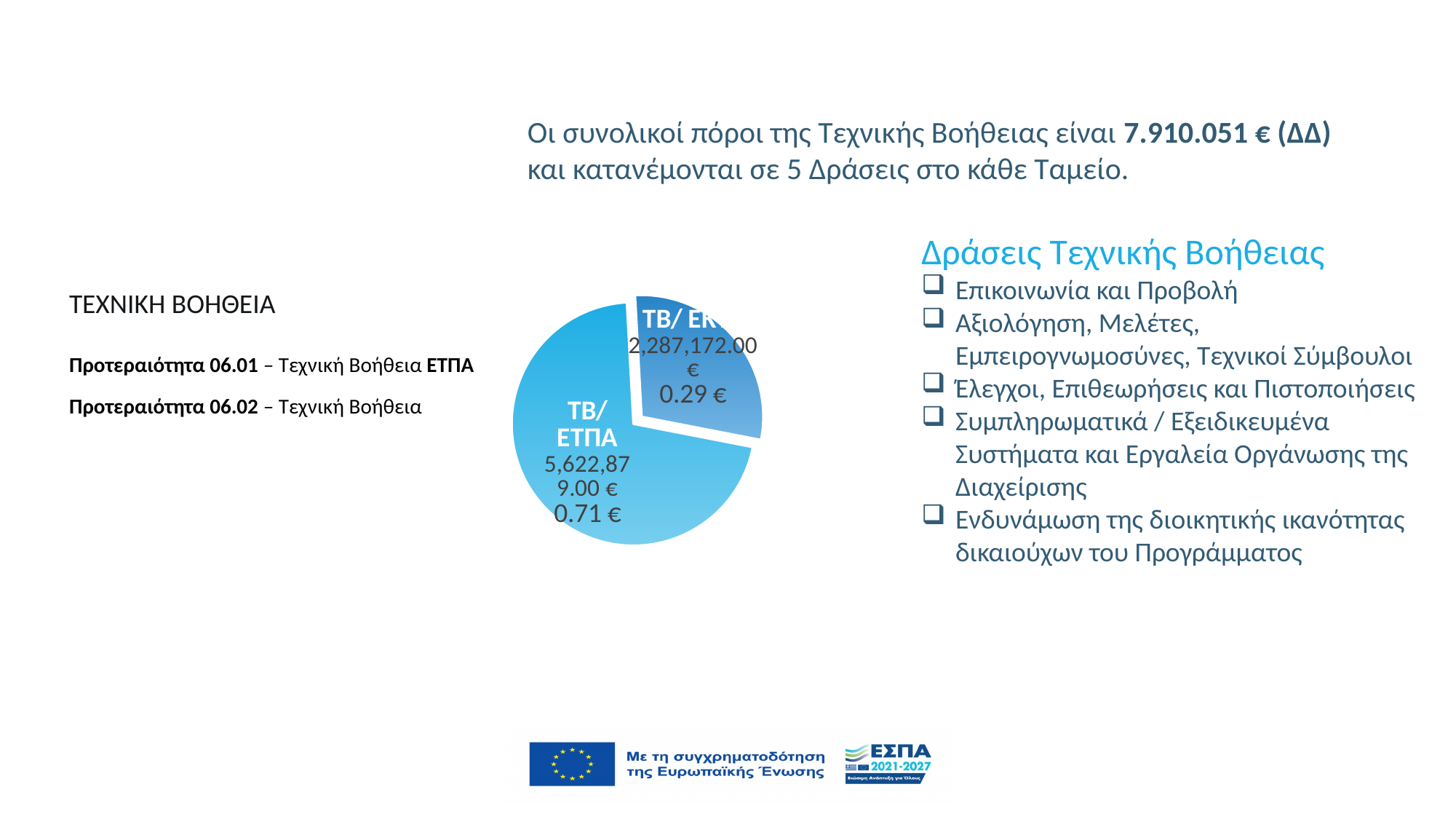
How many slices does the pie chart have? 2 What is the value shown for the smaller, separated slice of the pie chart? 2,287,172.00 € What type of chart is shown on the slide? pie chart What is the total of the two slice values shown in the pie chart? 7,910,051.00 € Which slice of the pie chart is the largest? ΤΒ/ ΕΤΠΑ What share label is printed on the ΤΒ/ ΕΤΠΑ slice of the pie chart? 0.71 € What is the difference between the ΤΒ/ ΕΤΠΑ slice value and the smaller slice value in the pie chart? 3,335,707.00 € Which is larger in the pie chart: the ΤΒ/ ΕΤΠΑ slice or the smaller separated slice? ΤΒ/ ΕΤΠΑ What share label is printed on the smaller slice of the pie chart? 0.29 € Which slice of the pie chart is pulled out (exploded) from the rest of the pie? the smaller slice (2,287,172.00 €) What is the value shown for the ΤΒ/ ΕΤΠΑ slice of the pie chart? 5,622,879.00 € Is the value of the ΤΒ/ ΕΤΠΑ slice greater or less than 5,000,000 €? greater